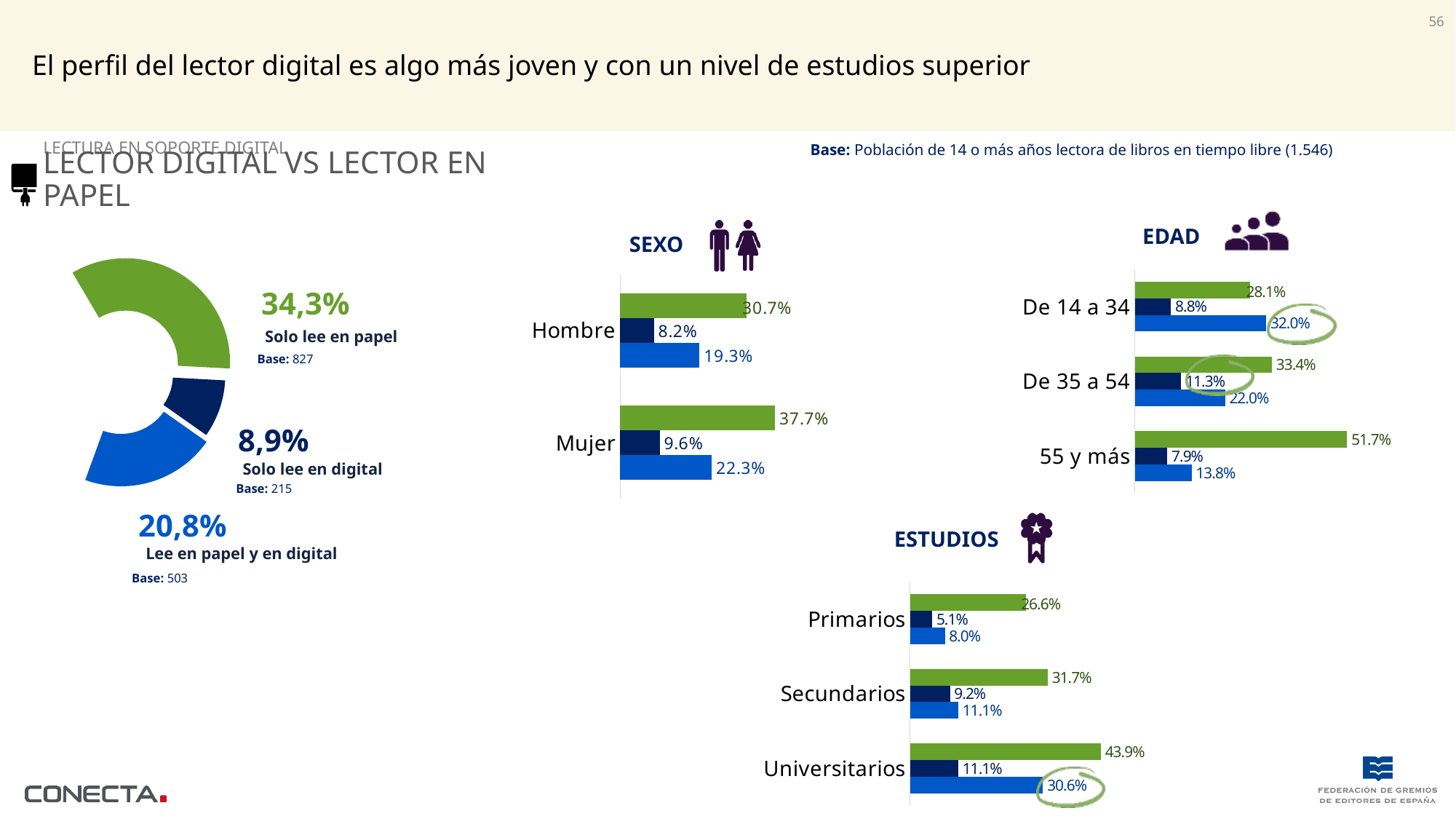
In the SEXO chart, what is the difference between the blue (bottom) bar values for Mujer and Hombre? 3.0% In the donut chart on the left, which segment has the smallest share? Solo lee en digital What kind of chart is the SEXO chart? Bar chart In the ESTUDIOS chart, do the green bar values rise or fall from Primarios to Universitarios? Rise In the SEXO chart, what is the value of the green bar for Mujer? 37.7% In the donut chart on the left, what percentage is shown for 'Lee en papel y en digital'? 20,8% In the EDAD chart, which age group has the highest green bar value? 55 y más In the donut chart on the left, what percentage is shown for 'Solo lee en papel'? 34,3% How many categories are shown in the ESTUDIOS chart? 3 In the ESTUDIOS chart, what is the value of the blue (bottom) bar for Universitarios? 30.6% In the EDAD chart, which is larger: the dark navy bar for 'De 35 a 54' or the dark navy bar for '55 y más'? De 35 a 54 In the EDAD chart, what is the value of the blue (bottom) bar for 'De 14 a 34'? 32.0%